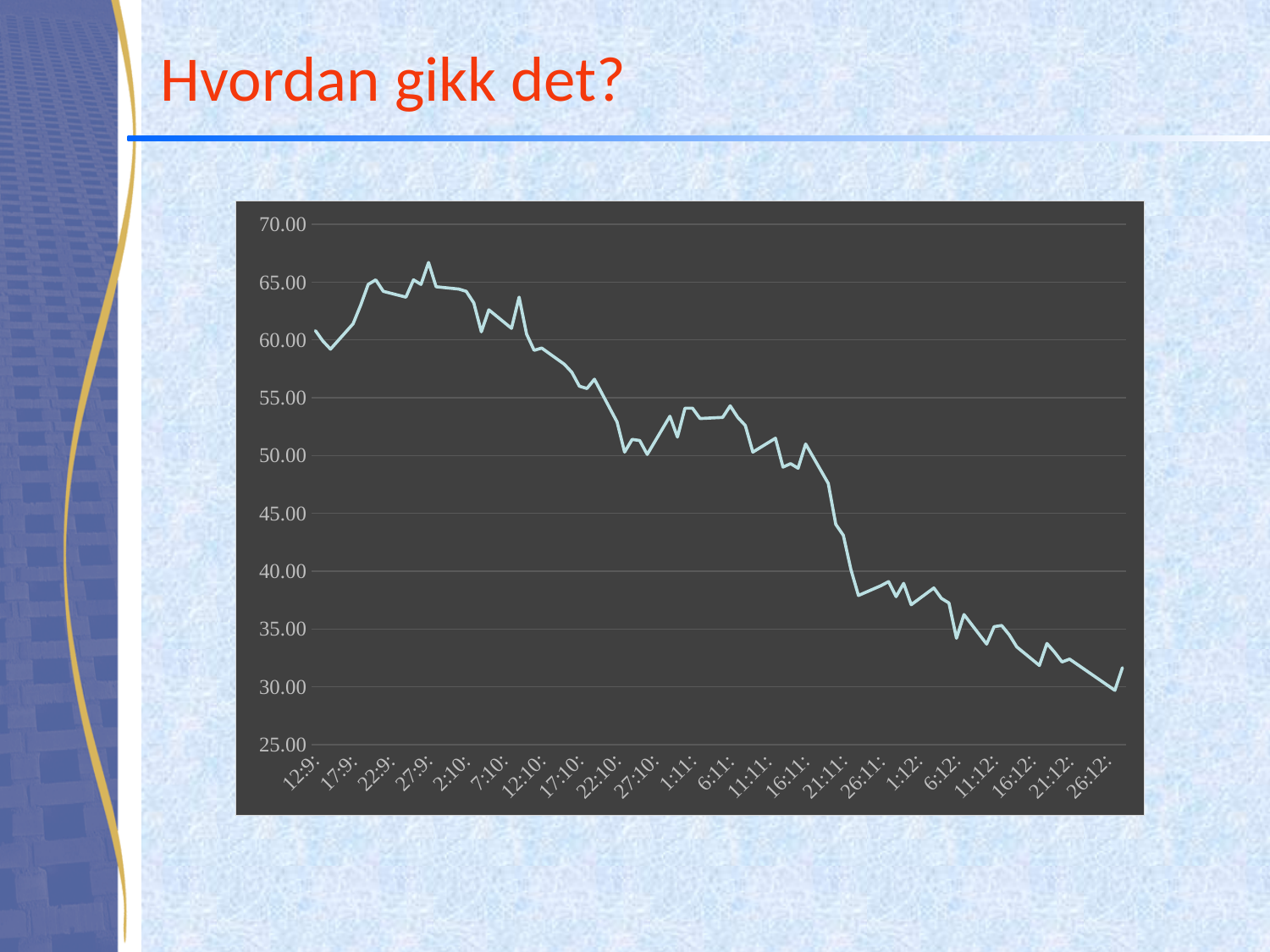
Is the value at 6:12: greater or less than 45.00? less Do the values generally rise or fall from left to right along the x axis? fall Is the value at 22:10: greater or less than 55.00? less Is the value at 27:9: greater or less than 60.00? greater Which is larger, the value at 12:9: or the value at 26:12:? 12:9: What kind of chart is shown on the slide? line chart What is the highest value shown on the y axis? 70.00 Which is larger, the value at 27:9: or the value at 22:10:? 27:9: What is the title of the slide containing the chart? Hvordan gikk det?